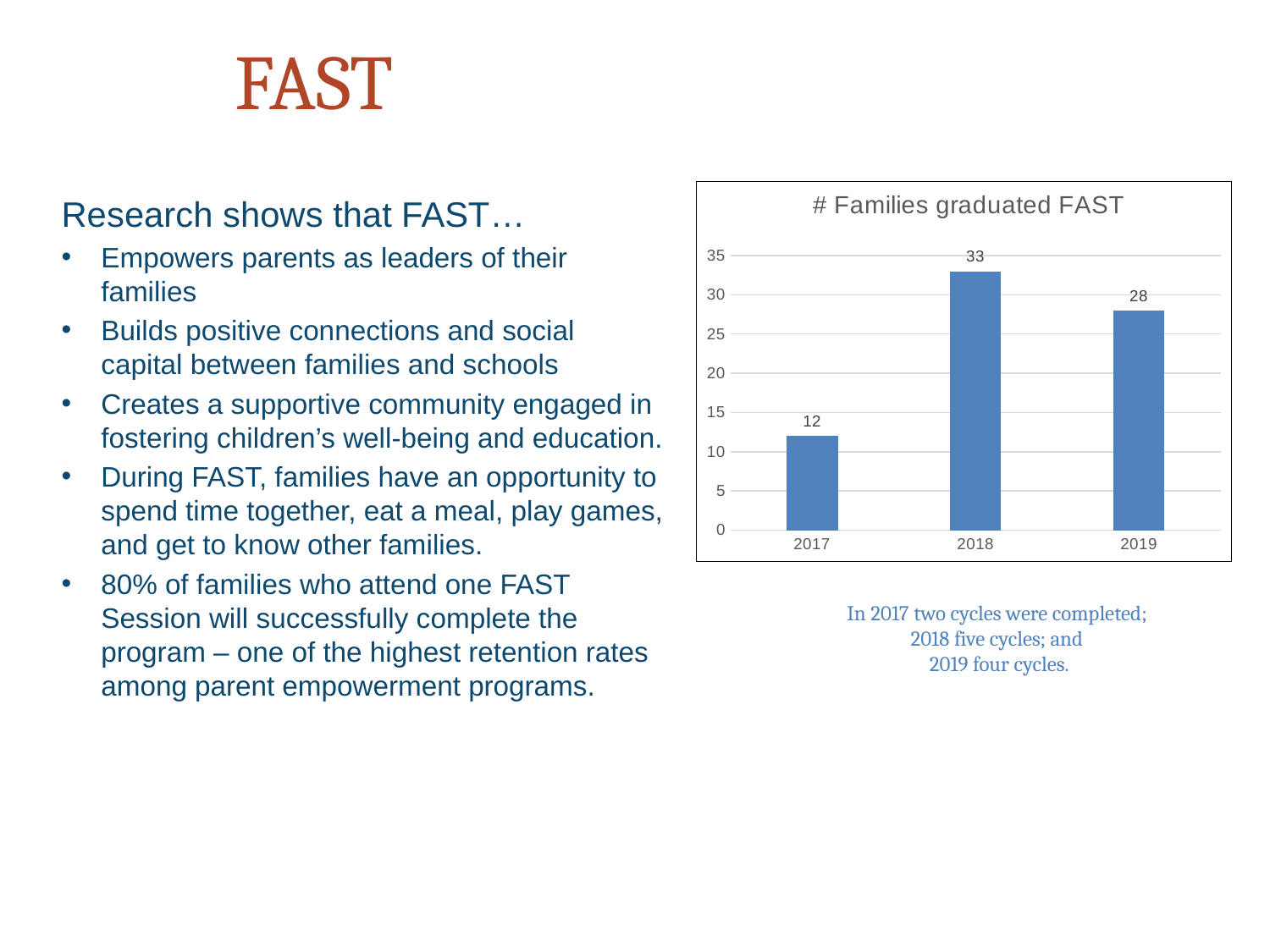
Is the value for 2019 greater or less than 25? greater What is the difference between the number of families graduated in 2018 and in 2019? 5 What is the title of the chart? # Families graduated FAST Which year had more families graduate FAST, 2017 or 2019? 2019 What kind of chart is used to show the number of families graduated FAST? Bar chart How many families graduated FAST in 2017? 12 Which year had the lowest number of families graduating FAST? 2017 How many families graduated FAST in 2018? 33 How many years are shown on the x axis of the chart? 3 What is the difference between the number of families graduated in 2018 and in 2017? 21 Which year had the highest number of families graduating FAST? 2018 How many families graduated FAST in 2019? 28